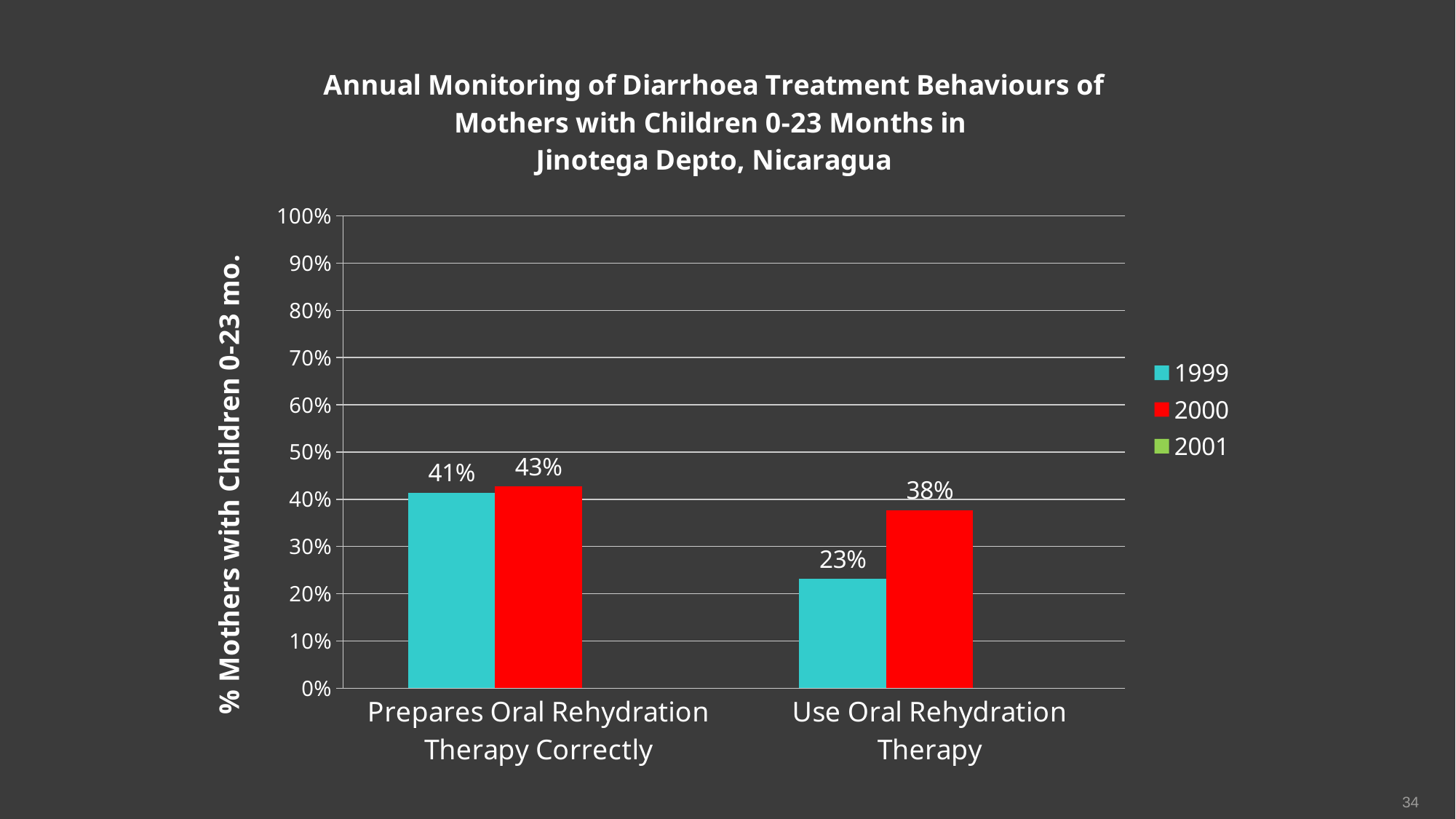
What is the difference between the 2000 and 1999 values for 'Use Oral Rehydration Therapy'? 15% What is the value for 1999 for 'Prepares Oral Rehydration Therapy Correctly'? 41% How many series does the legend list? 3 What is the value for 2000 for 'Prepares Oral Rehydration Therapy Correctly'? 43% How many categories are shown on the x axis? 2 What is the value for 2000 for 'Use Oral Rehydration Therapy'? 38% What is the value for 1999 for 'Use Oral Rehydration Therapy'? 23% What kind of chart is shown on the slide? Bar chart What is the label of the vertical axis? % Mothers with Children 0-23 mo. Is the 1999 value for 'Use Oral Rehydration Therapy' greater or less than 30%? less Which is larger for 'Prepares Oral Rehydration Therapy Correctly': the 1999 value or the 2000 value? 2000 Which category has the lowest value for 1999? Use Oral Rehydration Therapy